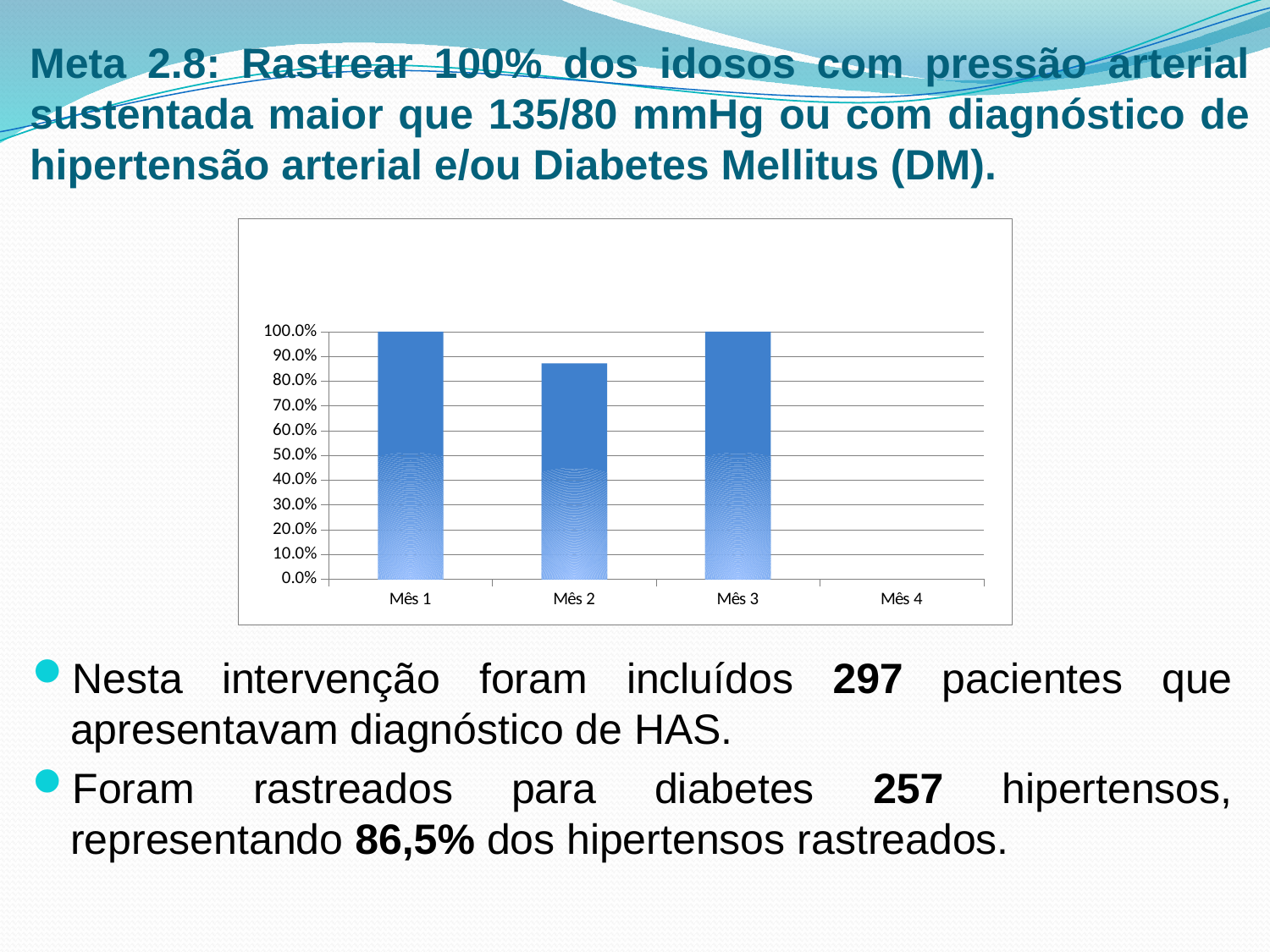
What is the highest value shown on the y axis of the chart? 100.0% Which is larger, the value for Mês 1 or the value for Mês 2? Mês 1 What is the value for Mês 3? 100.0% Which category on the x axis has no bar drawn? Mês 4 Is the value for Mês 2 greater or less than 90.0%? less How many categories are shown on the x axis of the chart? 4 Is the value for Mês 2 greater or less than 80.0%? greater What is the difference between the values for Mês 1 and Mês 3? 0.0% What kind of chart is shown on the slide? bar chart Which is larger, the value for Mês 2 or the value for Mês 3? Mês 3 What is the value for Mês 1? 100.0%